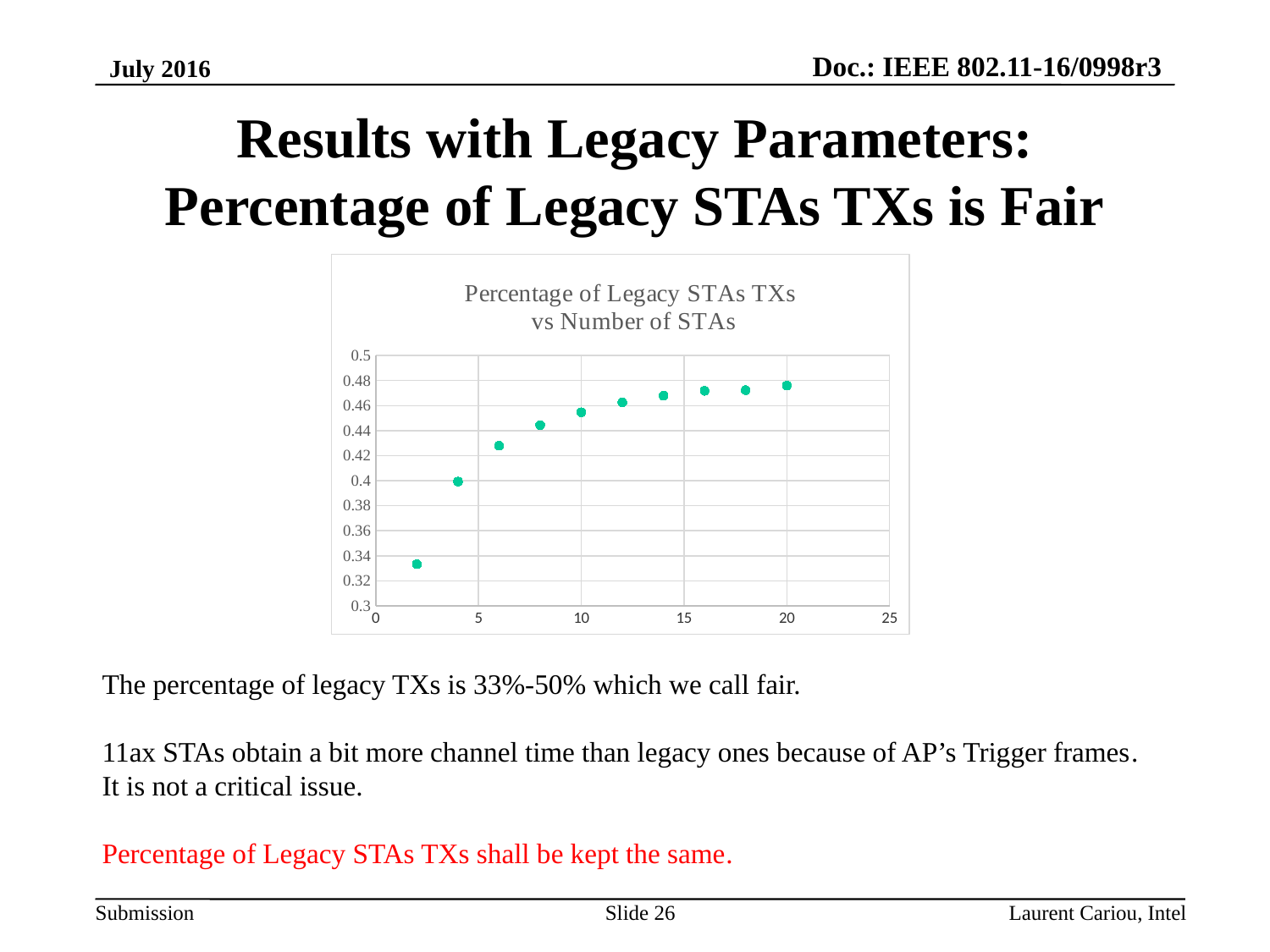
What is the title of the chart? Percentage of Legacy STAs TXs vs Number of STAs Is the value plotted at x = 10 greater or less than 0.44? greater Is the value plotted at x = 2 greater or less than 0.36? less Do the plotted values rise or fall as the number of STAs increases along the x axis? rise Which has the larger plotted value, x = 2 or x = 4? x = 4 What kind of chart is shown on the slide? scatter chart Is the value plotted at x = 20 greater or less than 0.46? greater How many data points are plotted in the chart? 10 Which has the larger plotted value, x = 6 or x = 12? x = 12 At which x value (number of STAs) is the plotted percentage lowest? 2 What is the highest value shown on the chart's y axis? 0.5